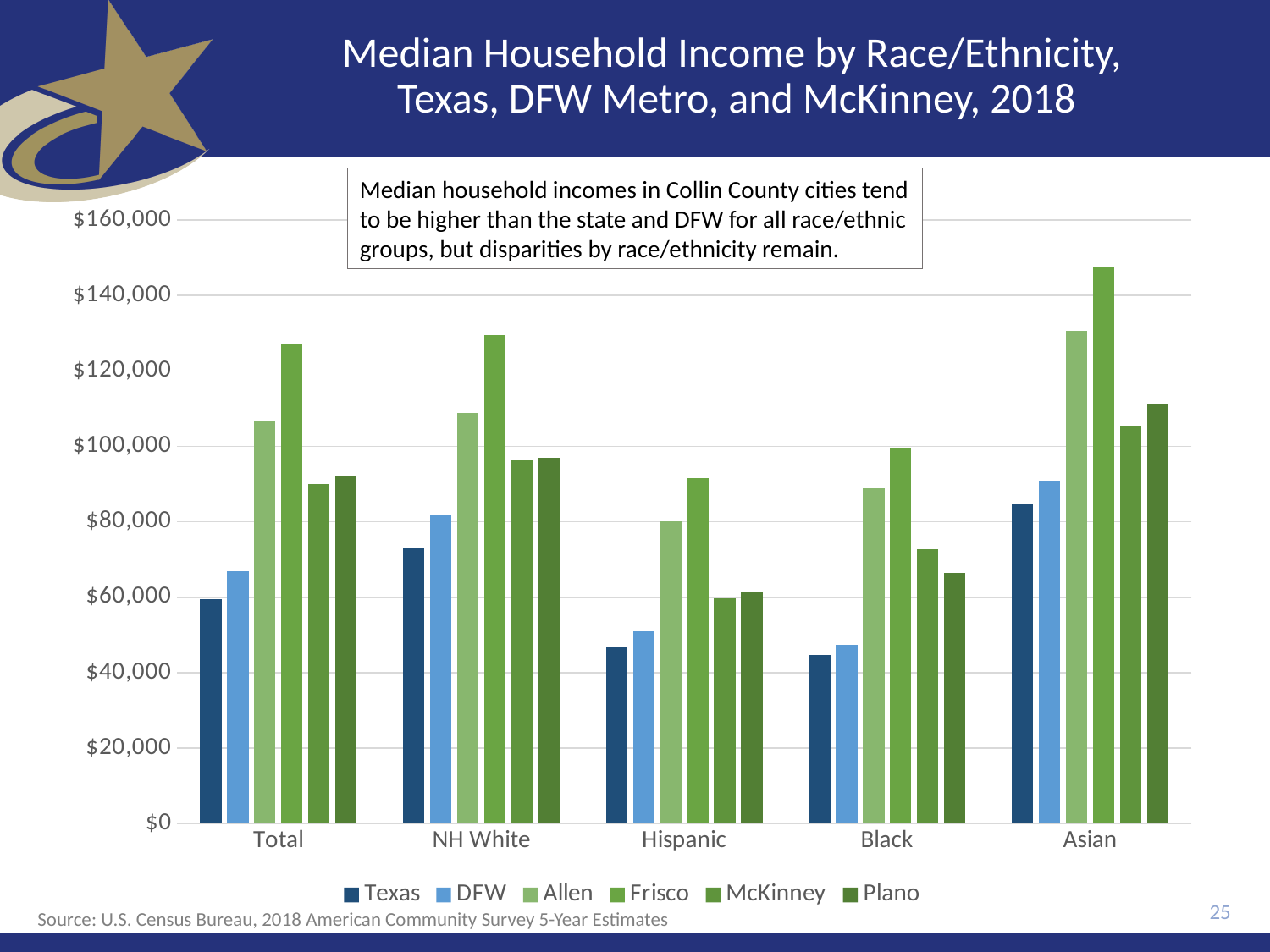
How many race/ethnicity categories are shown on the x axis? 5 Is the value for Frisco in the Total category greater or less than $120,000? greater What is the title of the chart? Median Household Income by Race/Ethnicity, Texas, DFW Metro, and McKinney, 2018 Is the value for Frisco in the Asian category greater or less than $140,000? greater Across the race/ethnicity categories, in which category is the Frisco bar the highest? Asian In the Total category, which is larger: Texas or DFW? DFW Is the value for Texas in the Hispanic category greater or less than $60,000? less For the Black category, which series has the lowest median household income? Texas For the Asian category, which series has the highest median household income? Frisco In the NH White category, which is larger: Allen or McKinney? Allen How many series does the legend list? 6 What kind of chart is shown on the slide? bar chart